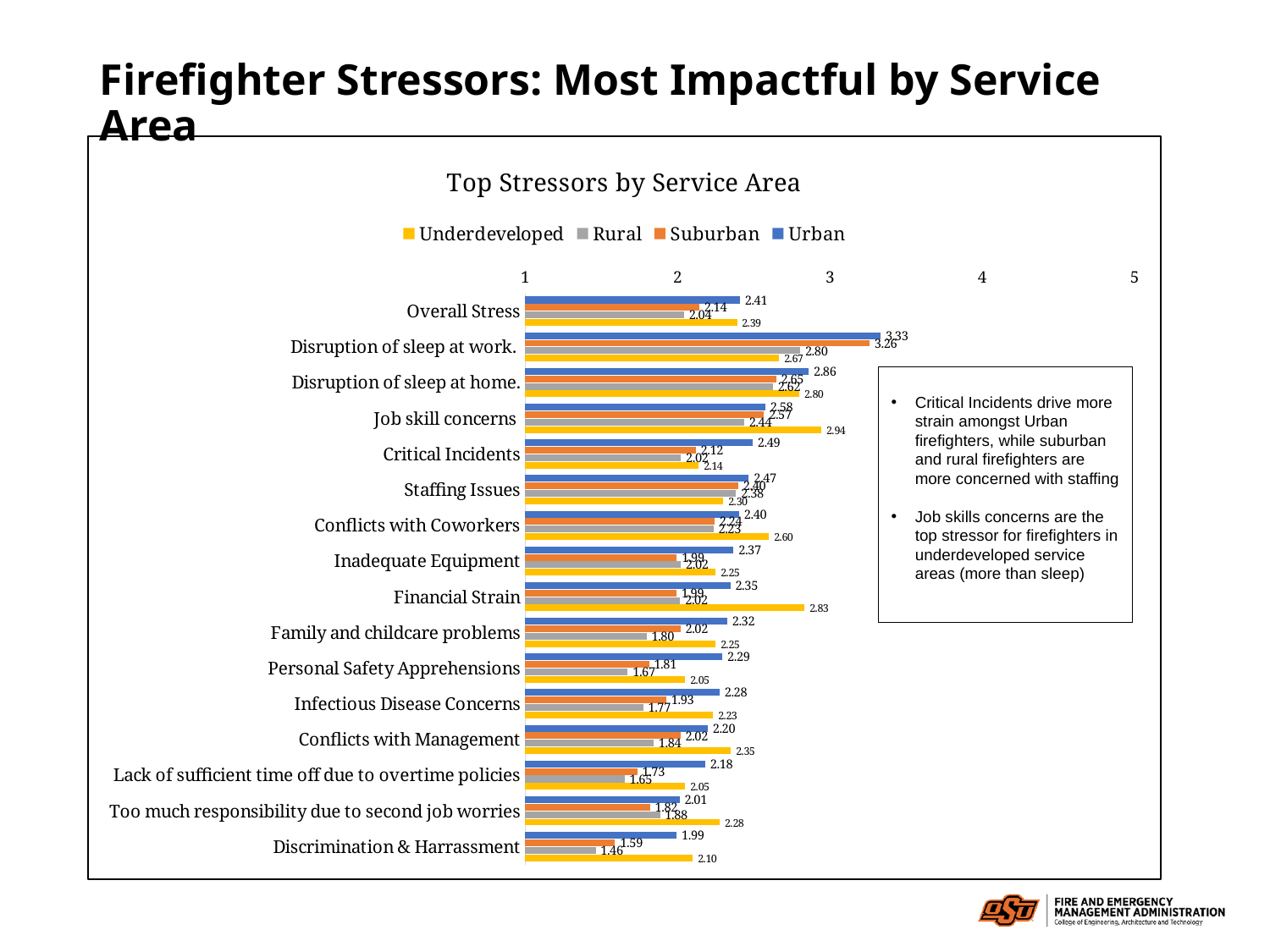
How many series does the legend list? 4 Which stressor has the highest Urban value? Disruption of sleep at work. Which stressor has the lowest Rural value? Discrimination & Harrassment What is the difference between the Urban and Rural values for Discrimination & Harrassment? 0.53 For Financial Strain, which is larger: the Underdeveloped value or the Urban value? Underdeveloped What is the Rural value for Discrimination & Harrassment? 1.46 What is the Underdeveloped value for Job skill concerns? 2.94 How many stressor categories are shown on the chart? 16 Is the Urban value for Disruption of sleep at work greater or less than 3? greater What kind of chart is shown on the slide? Bar chart What is the Urban value for Critical Incidents? 2.49 What is the Urban value for Disruption of sleep at work? 3.33